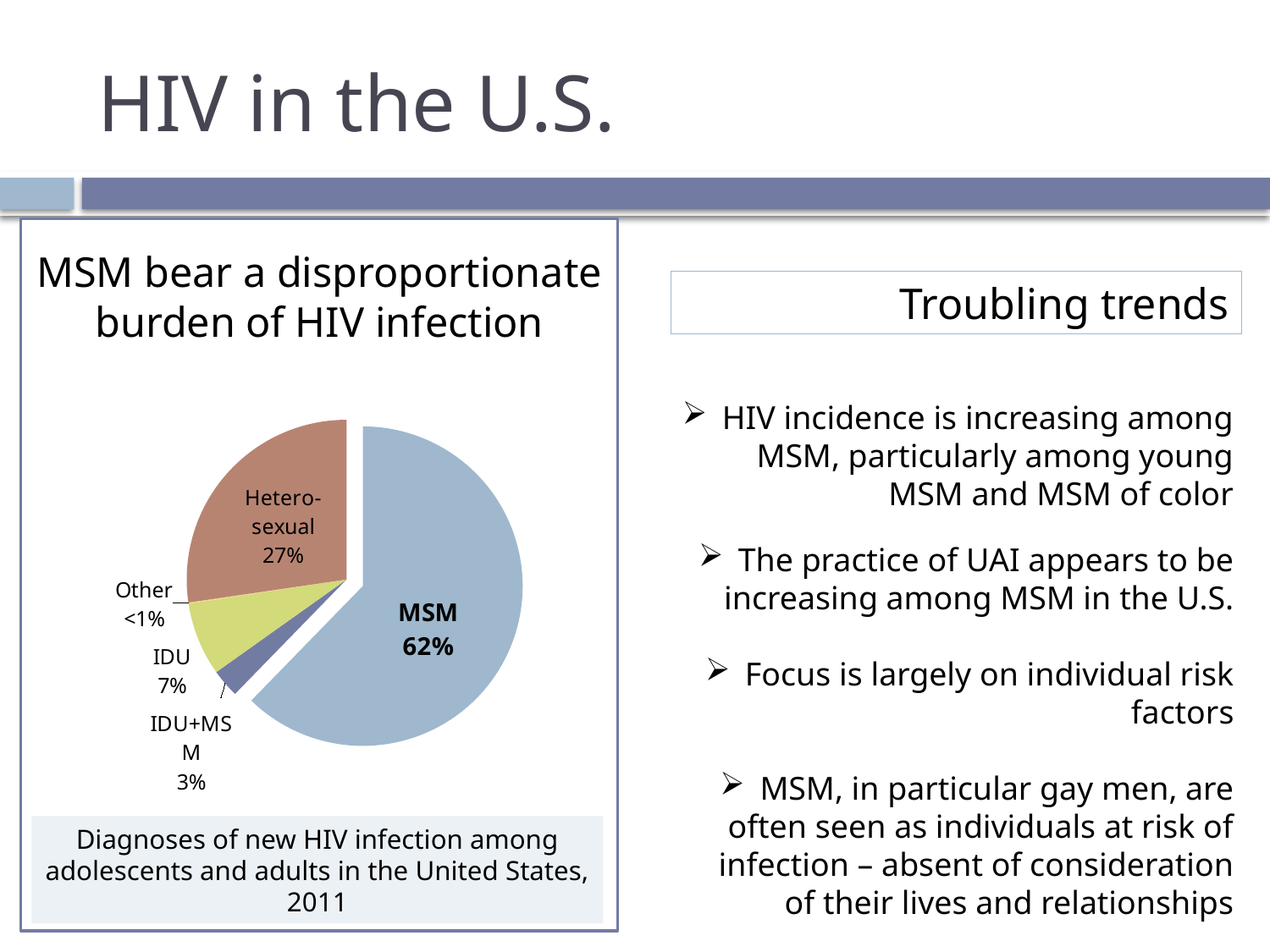
What is the difference in percentage points between the MSM and Heterosexual slices? 35 What share of new HIV diagnoses is attributed to IDU+MSM? 3% How many slices does the pie chart have? 5 Which category has the largest slice of the pie? MSM What kind of chart is shown on the slide? pie chart Which slice is larger, IDU or IDU+MSM? IDU Which category has the smallest slice of the pie? Other What share of new HIV diagnoses is attributed to heterosexual transmission? 27% What share of new HIV diagnoses is attributed to IDU? 7% What share of new HIV diagnoses is attributed to MSM? 62% What share of new HIV diagnoses is attributed to Other? <1% What is the caption below the pie chart? Diagnoses of new HIV infection among adolescents and adults in the United States, 2011